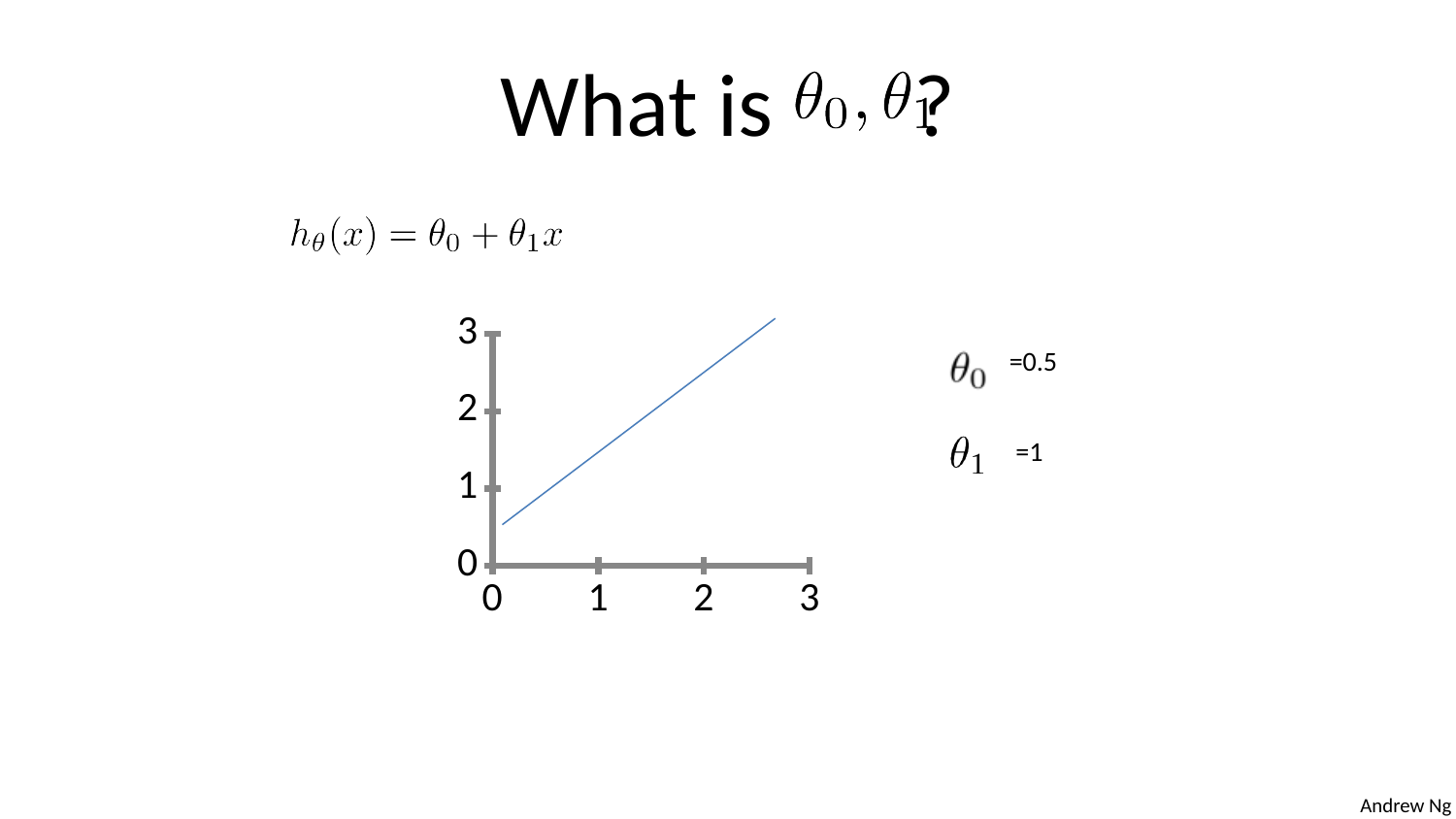
How many lines are plotted on the chart? 1 Is the value of the line at x = 0 greater or less than 1? less Is the value of the line at x = 2 greater or less than 3? less What kind of chart is shown on the slide? line chart Is the value of the line higher at x = 2 or at x = 0? x = 2 Is the value of the line at x = 1 greater or less than 2? less Does the plotted line rise or fall as x increases from 0 to 3? rise How many tick labels are shown on the x axis? 4 What colour is the plotted line? blue What is the highest tick label shown on the y axis? 3